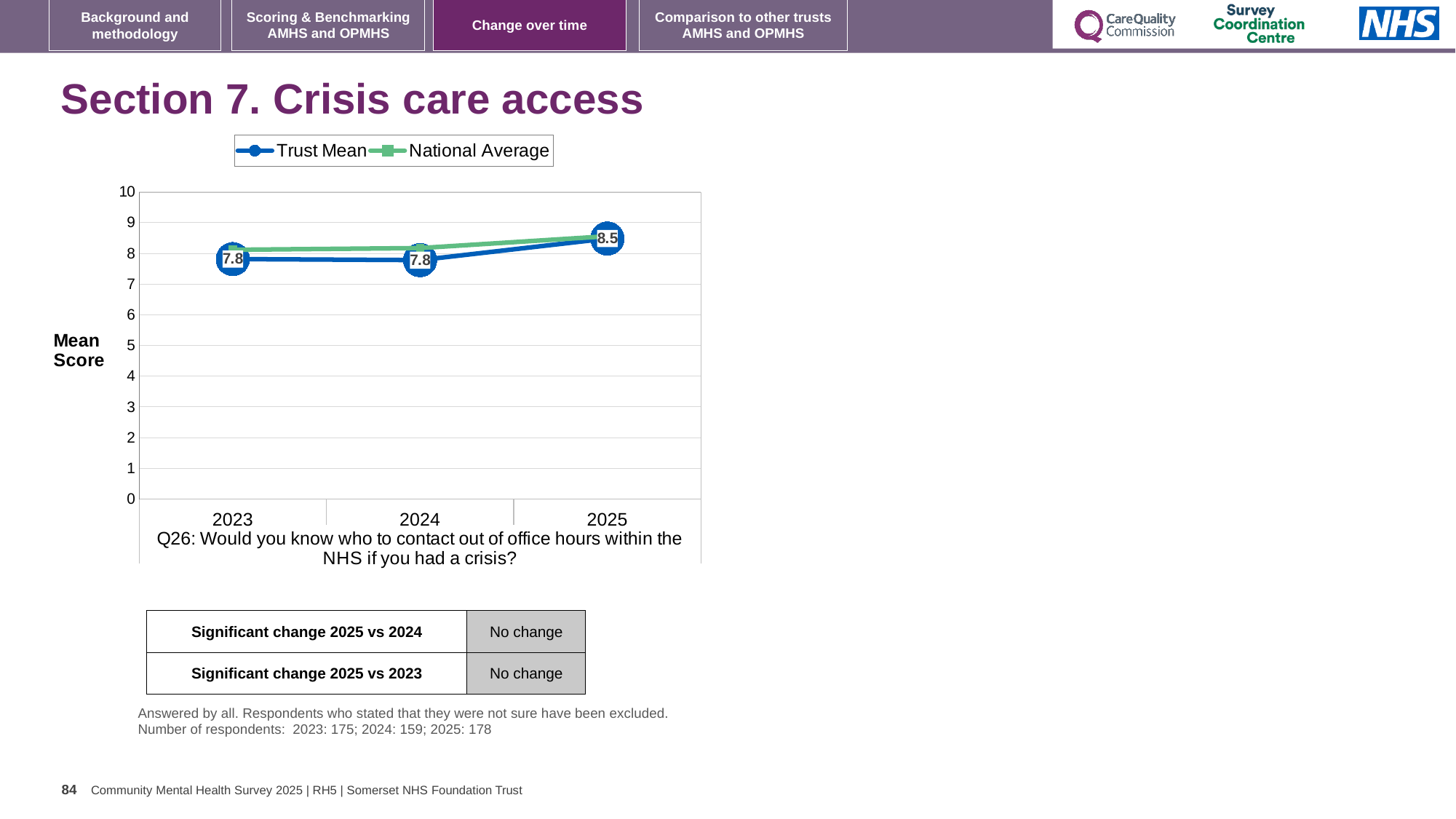
How many series does the legend list? 2 In which year is the Trust Mean highest? 2025 What kind of chart is shown on the slide? line chart Is the National Average value for 2024 greater or less than 7? greater How many years are plotted on the x axis? 3 Which is larger, the Trust Mean in 2025 or the Trust Mean in 2024? 2025 What is the Trust Mean value for 2024? 7.8 In 2023, which series has the higher value, Trust Mean or National Average? National Average Does the Trust Mean rise or fall from 2024 to 2025? rise What is the Trust Mean value for 2023? 7.8 What is the difference between the Trust Mean in 2025 and in 2023? 0.7 What is the Trust Mean value for 2025? 8.5